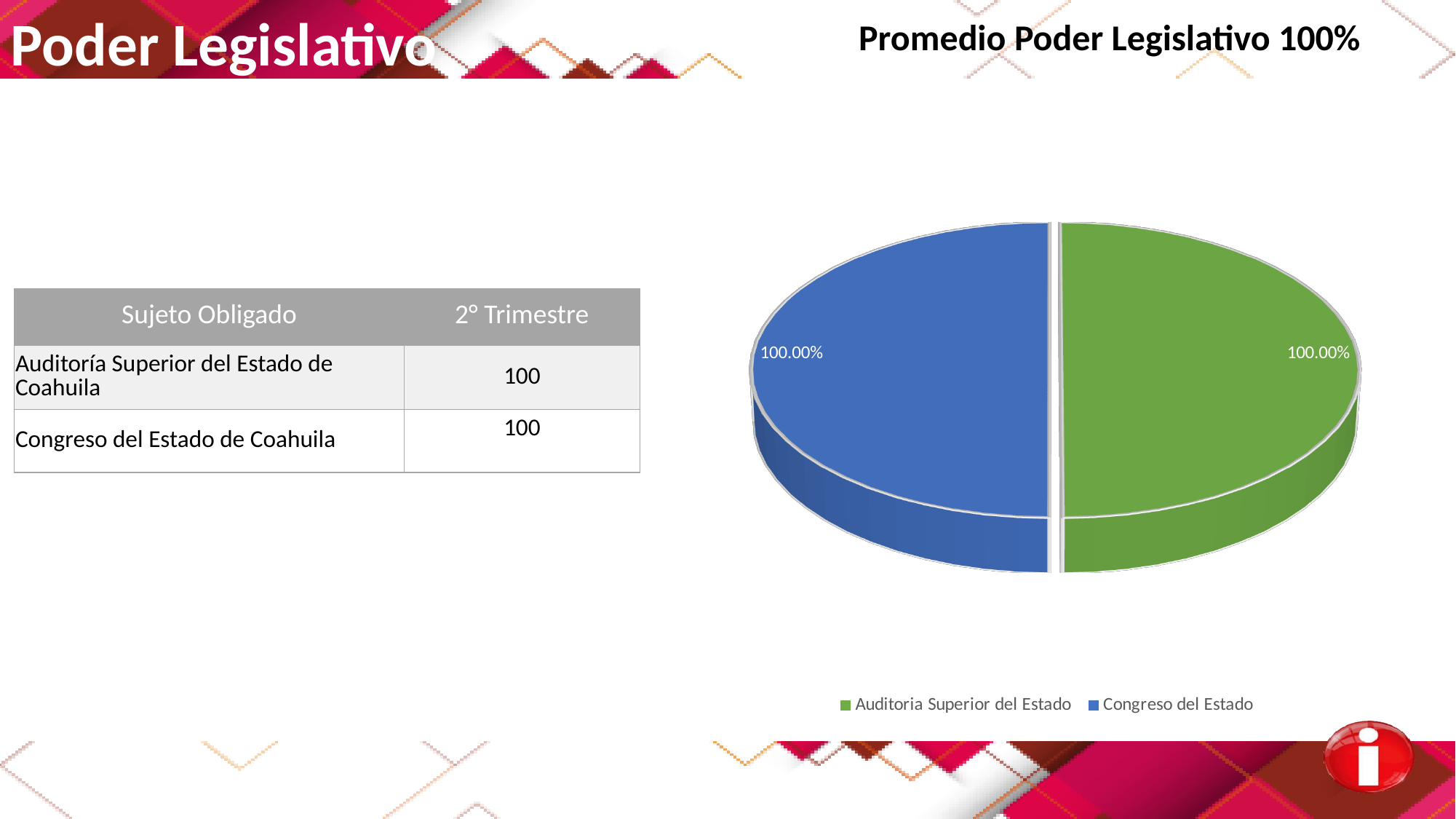
How many slices does the pie chart have? 2 What data label is shown on the Auditoria Superior del Estado slice of the pie chart? 100.00% What kind of chart is shown on the slide? Pie chart Which colour represents Auditoria Superior del Estado in the pie chart? Green Which colour represents Congreso del Estado in the pie chart? Blue What data label is shown on the Congreso del Estado slice of the pie chart? 100.00% Is the data label for the Congreso del Estado slice greater or less than 50%? greater How many entries does the pie chart's legend list? 2